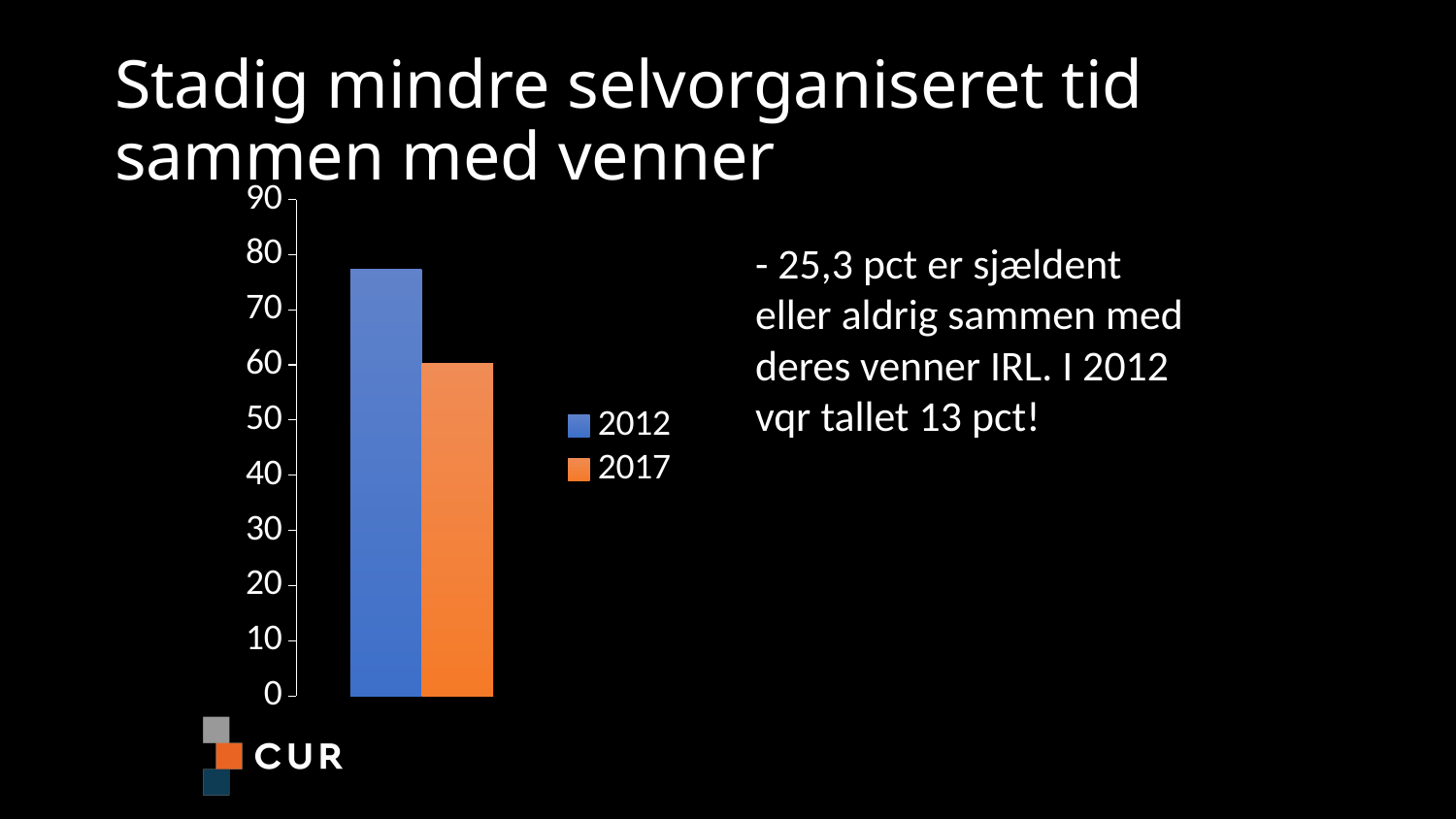
Is the value for 2012 greater or less than 70? greater Which series has the taller bar, 2012 or 2017? 2012 Which series has the highest value? 2012 What is the highest value shown on the vertical axis? 90 Is the value for 2012 greater or less than 80? less How many series does the legend list? 2 How many bars are plotted in the chart? 2 What colour is the bar for 2017? orange Is the value for 2017 greater or less than 50? greater What kind of chart is shown on the slide? bar chart Which series has the lowest value? 2017